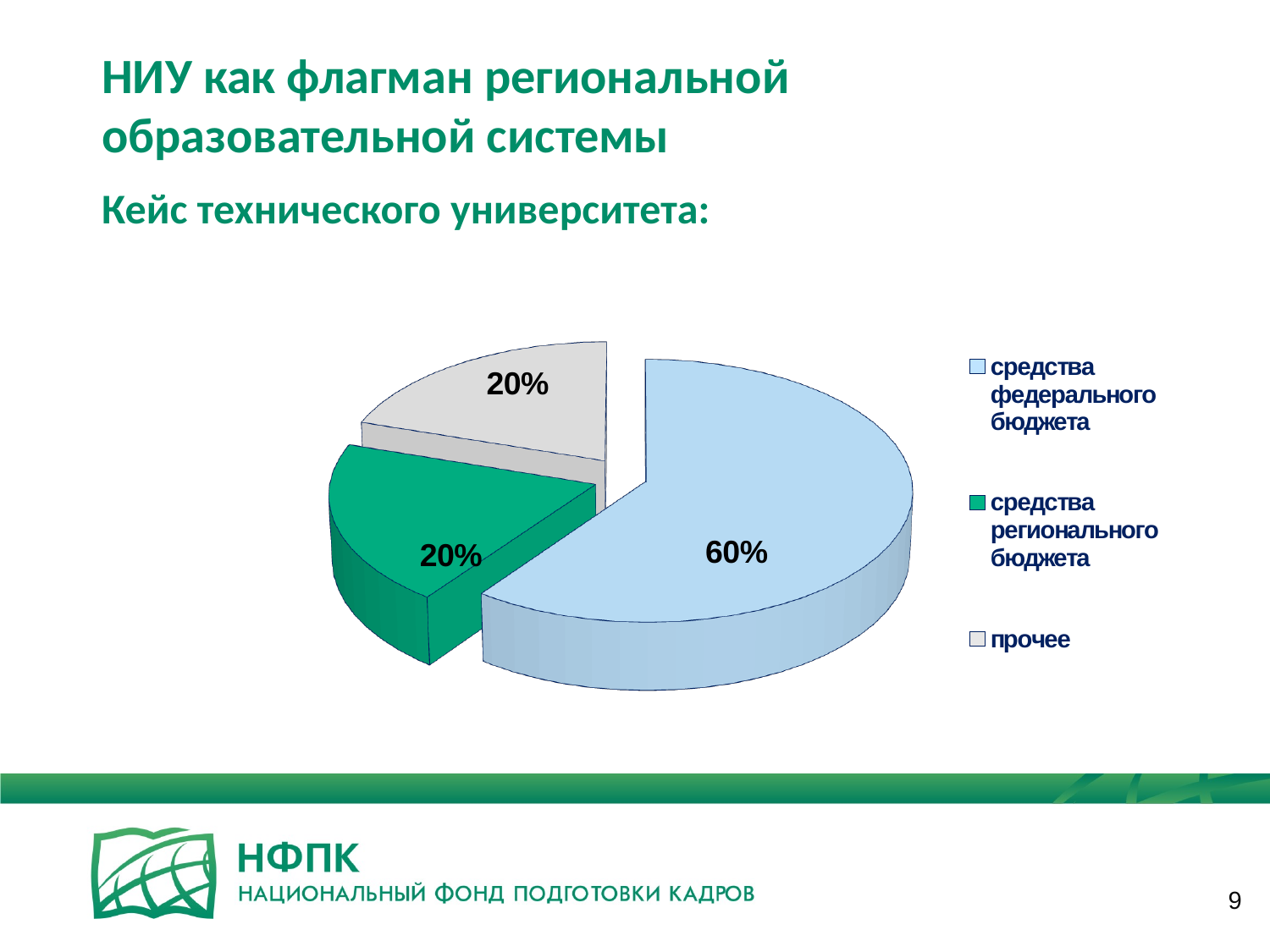
Which legend entry is shown in light blue? средства федерального бюджета What share of the pie is labelled for прочее? 20% What share of the pie is labelled for средства регионального бюджета? 20% Which category has the largest slice of the pie? средства федерального бюджета What colour is the slice for средства регионального бюджета? green Which is larger: the slice for средства федерального бюджета or the slice for средства регионального бюджета? средства федерального бюджета How many entries does the legend list? 3 Is the share for средства федерального бюджета greater or less than 50%? greater What is the difference in percentage points between the share for средства федерального бюджета and the share for прочее? 40 percentage points How many slices does the pie chart have? 3 What kind of chart is shown on the slide? pie chart What share of the pie is labelled for средства федерального бюджета? 60%